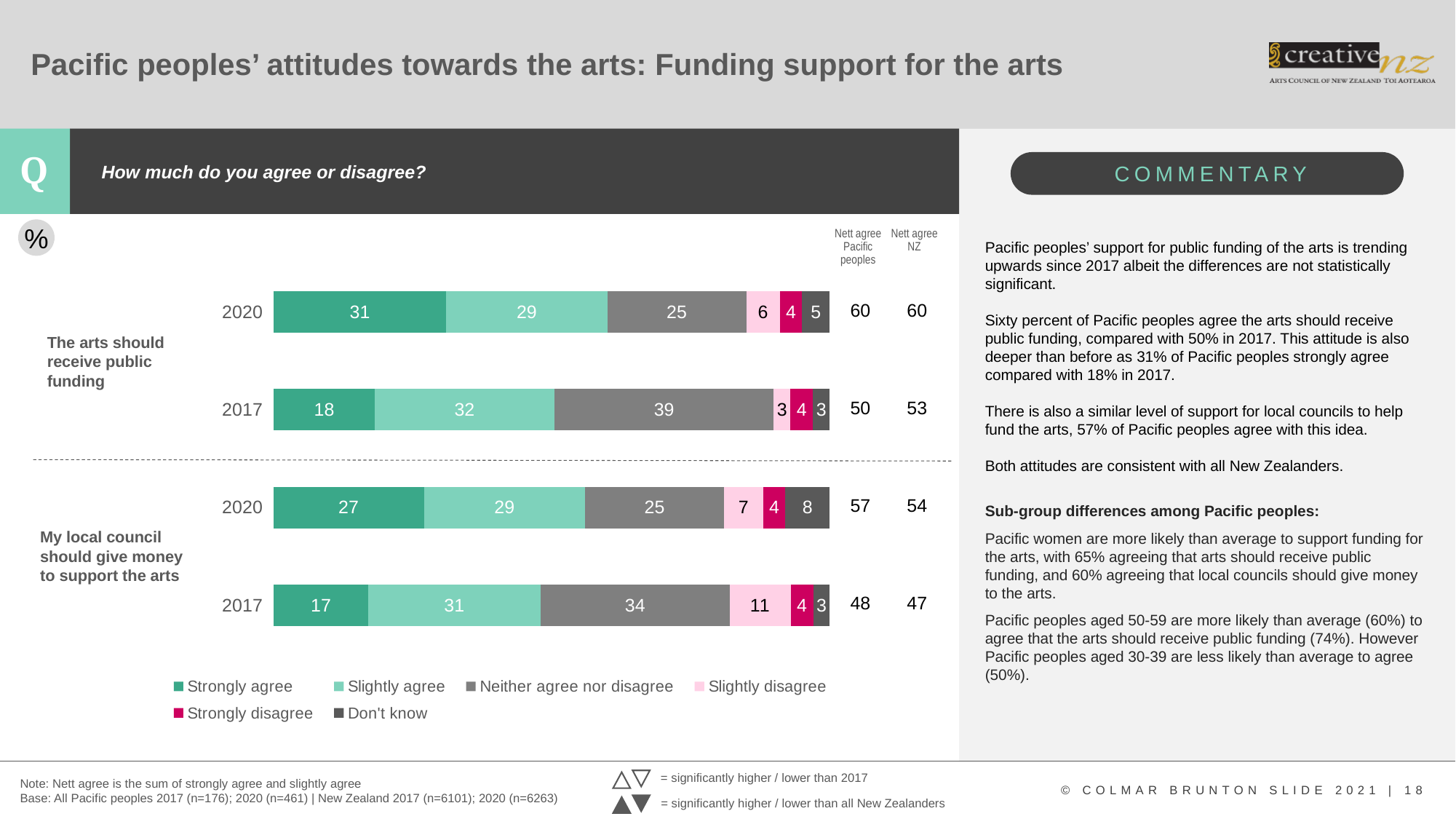
Which of the four bars has the largest 'Strongly agree' segment? The arts should receive public funding, 2020 How many series does the legend list? 6 What is the Nett agree figure for Pacific peoples in 2020 for 'My local council should give money to support the arts'? 57 What percentage of Pacific peoples strongly agreed in 2020 that the arts should receive public funding? 31 How many bars are plotted in the chart? 4 What percentage of Pacific peoples neither agreed nor disagreed in 2017 that the arts should receive public funding? 39 What is the Nett agree figure for NZ in 2017 for 'The arts should receive public funding'? 53 What percentage of Pacific peoples slightly disagreed in 2017 that their local council should give money to support the arts? 11 What type of chart is shown on the slide? Stacked bar chart By how many percentage points did 'Strongly agree' for 'The arts should receive public funding' increase from 2017 to 2020? 13 Which of the four bars has the smallest 'Strongly agree' segment? My local council should give money to support the arts, 2017 Is the 'Don't know' value larger for 'My local council should give money to support the arts' in 2020 or in 2017? 2020